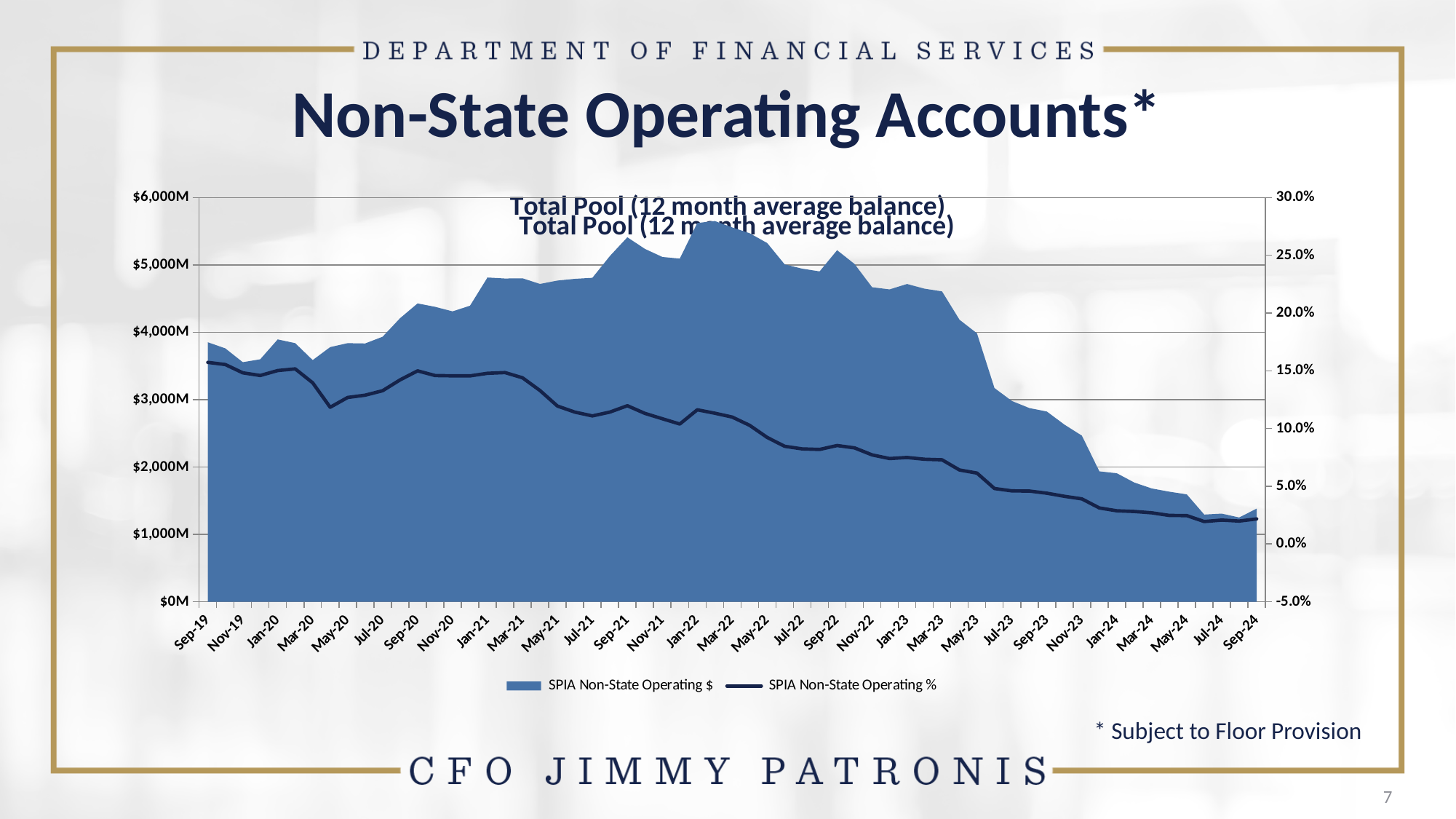
What are the two series named in the chart legend? SPIA Non-State Operating $ and SPIA Non-State Operating % What is the title printed inside the chart area? Total Pool (12 month average balance) Is the SPIA Non-State Operating $ value for Mar-22 greater or less than $5,000M? greater Is the SPIA Non-State Operating $ value for Sep-24 greater or less than $2,000M? less What kind of chart is used to show the SPIA Non-State Operating $ series? Area chart How many series does the chart legend list? 2 Is the SPIA Non-State Operating % value for Sep-24 greater or less than 5.0%? less Which is larger, the SPIA Non-State Operating $ value for Sep-19 or for Sep-24? Sep-19 Overall, does the SPIA Non-State Operating % line rise or fall from Sep-19 to Sep-24? fall